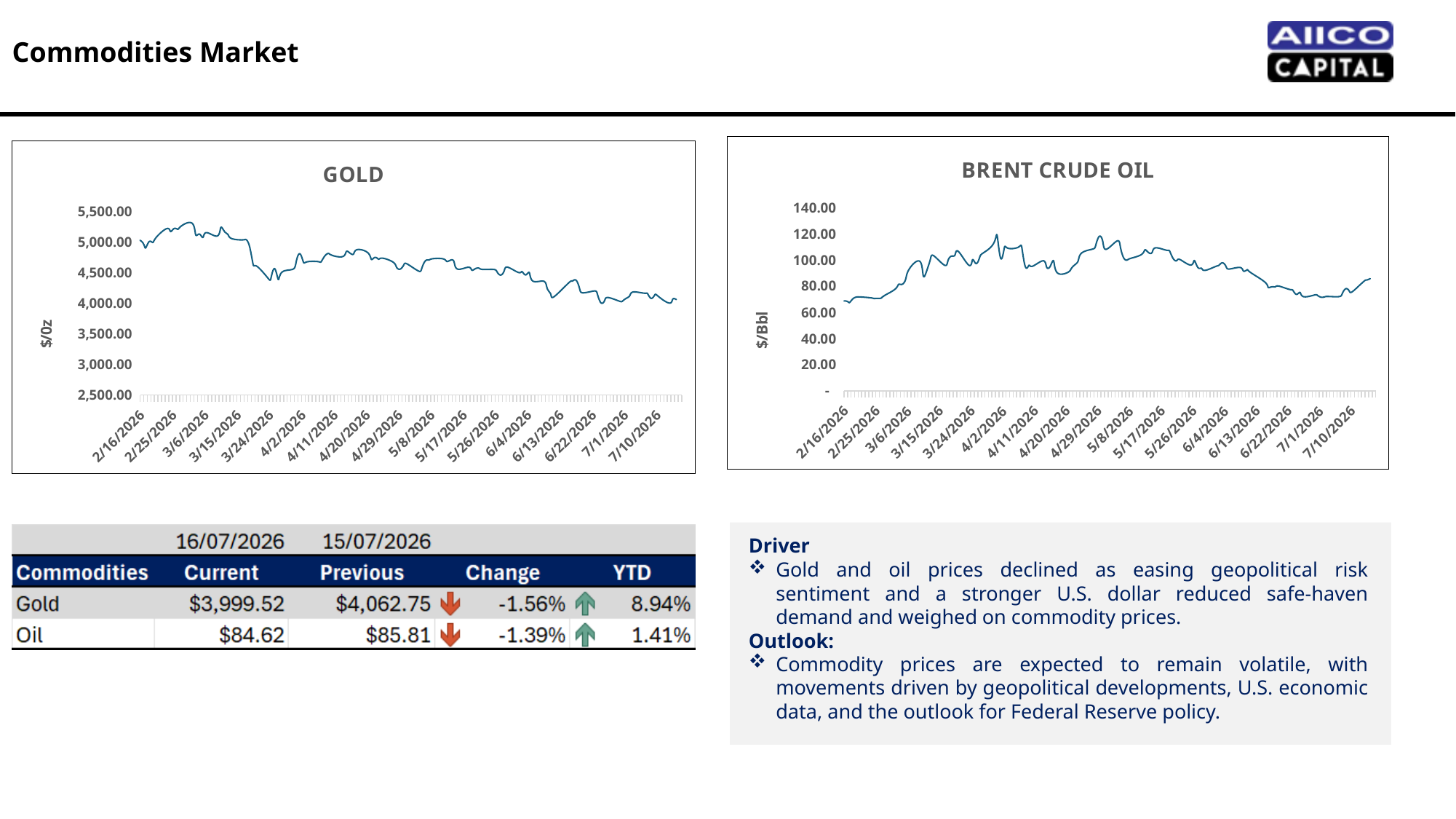
In the GOLD chart, does the price overall rise or fall from 2/16/2026 to 7/10/2026? fall In the BRENT CRUDE OIL chart, is the value at 2/16/2026 greater or less than 80.00? less What kind of chart is the GOLD chart? line chart What is the y-axis label on the GOLD chart? $/Oz In the BRENT CRUDE OIL chart, is the highest value reached greater or less than 100.00? greater What is the y-axis label on the BRENT CRUDE OIL chart? $/Bbl What kind of chart is the BRENT CRUDE OIL chart? line chart In the GOLD chart, is the highest value reached greater or less than 5,000.00? greater In the BRENT CRUDE OIL chart, does the price rise or fall between 4/29/2026 and 6/22/2026? fall In the GOLD chart, which is higher: the value at 2/16/2026 or the value at 7/10/2026? 2/16/2026